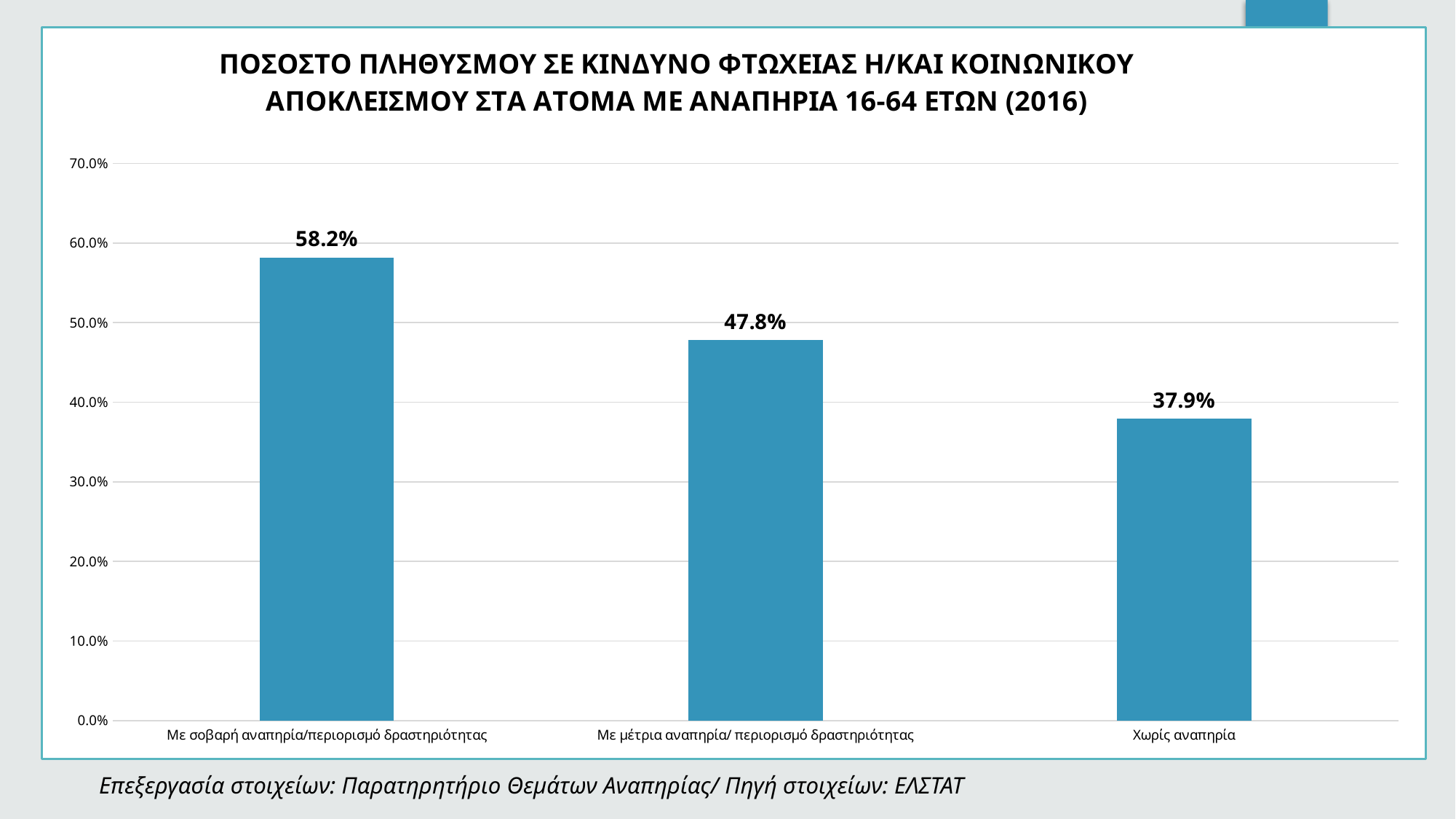
Which category has the highest value? Με σοβαρή αναπηρία/περιορισμό δραστηριότητας Which is larger: the value for 'Με μέτρια αναπηρία/ περιορισμό δραστηριότητας' or the value for 'Χωρίς αναπηρία'? Με μέτρια αναπηρία/ περιορισμό δραστηριότητας Do the values rise or fall from left to right along the x axis? fall What is the difference between the values for 'Με σοβαρή αναπηρία/περιορισμό δραστηριότητας' and 'Με μέτρια αναπηρία/ περιορισμό δραστηριότητας'? 10.4% Which category has the lowest value? Χωρίς αναπηρία What is the value for 'Με σοβαρή αναπηρία/περιορισμό δραστηριότητας'? 58.2% How many categories are shown on the x axis? 3 What is the value for 'Με μέτρια αναπηρία/ περιορισμό δραστηριότητας'? 47.8% What is the difference between the values for 'Με σοβαρή αναπηρία/περιορισμό δραστηριότητας' and 'Χωρίς αναπηρία'? 20.3% What kind of chart is shown on the slide? bar chart What is the value for 'Χωρίς αναπηρία'? 37.9% Is the value for 'Χωρίς αναπηρία' greater or less than 40.0%? less